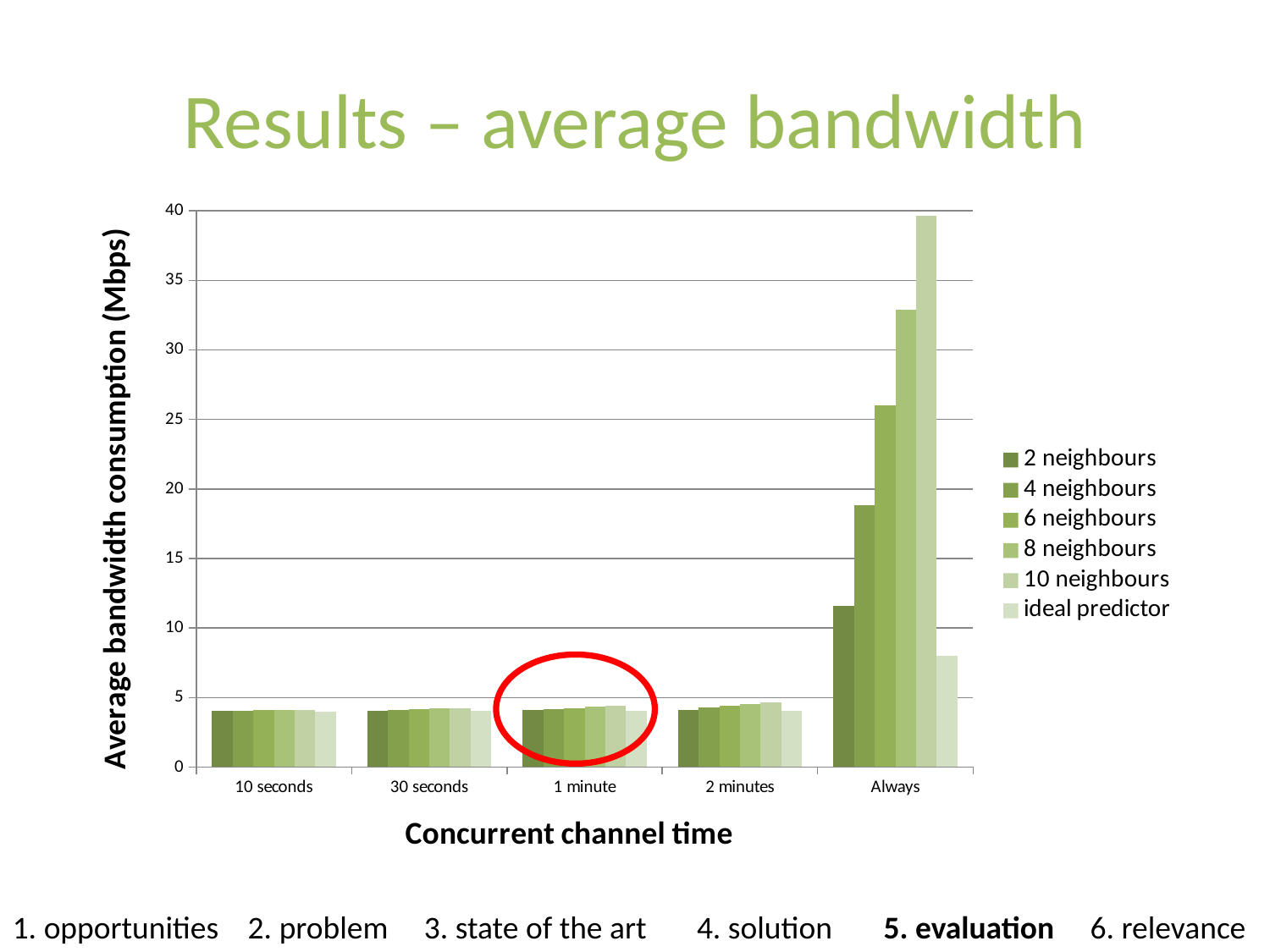
What kind of chart is shown on the slide? bar chart In the Always category, which series has the lowest average bandwidth consumption? ideal predictor Is the value for 2 neighbours in the 10 seconds category greater or less than 5? less In the Always category, which series has the highest average bandwidth consumption? 10 neighbours Is the value for 2 neighbours in the Always category greater or less than 10? greater Is the value for 10 neighbours in the Always category greater or less than 35? greater Which concurrent channel time category has the highest average bandwidth consumption for 10 neighbours? Always How many series does the legend list? 6 How many concurrent channel time categories are shown on the x axis? 5 What is the title of the y axis? Average bandwidth consumption (Mbps) In the Always category, which is larger: 4 neighbours or ideal predictor? 4 neighbours